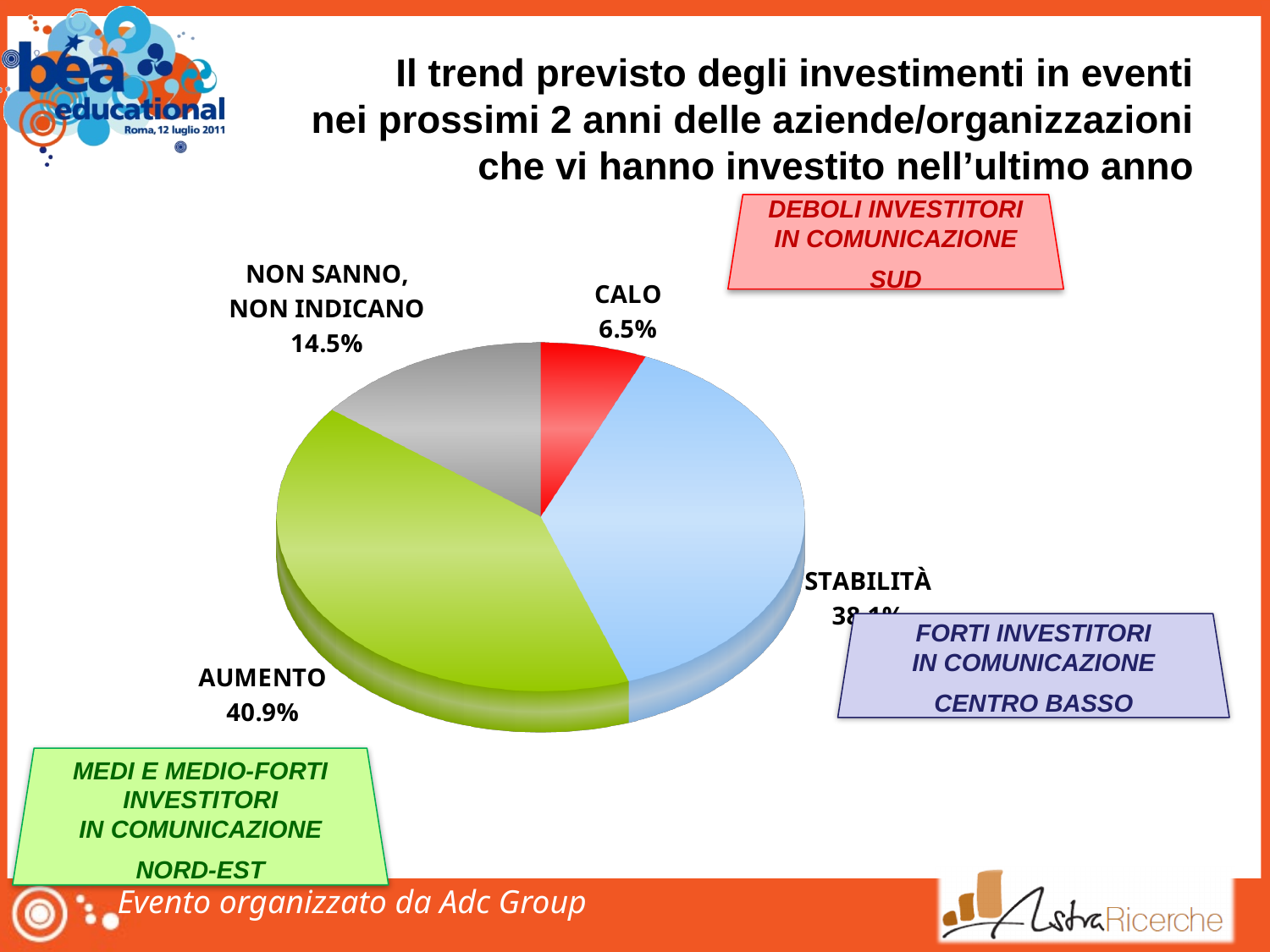
How many slices does the pie chart have? 4 What is the difference in percentage points between AUMENTO and CALO? 34.4 percentage points What percentage is shown for NON SANNO, NON INDICANO? 14.5% What is the difference in percentage points between NON SANNO, NON INDICANO and CALO? 8 percentage points What kind of chart is shown on the slide? pie chart What percentage is shown for CALO? 6.5% What colour is the AUMENTO slice of the pie? green What colour is the CALO slice of the pie? red Which category has the smallest slice of the pie? CALO What is the difference in percentage points between AUMENTO and NON SANNO, NON INDICANO? 26.4 percentage points Which is larger, the slice for CALO or the slice for NON SANNO, NON INDICANO? NON SANNO, NON INDICANO What percentage is shown for AUMENTO? 40.9%